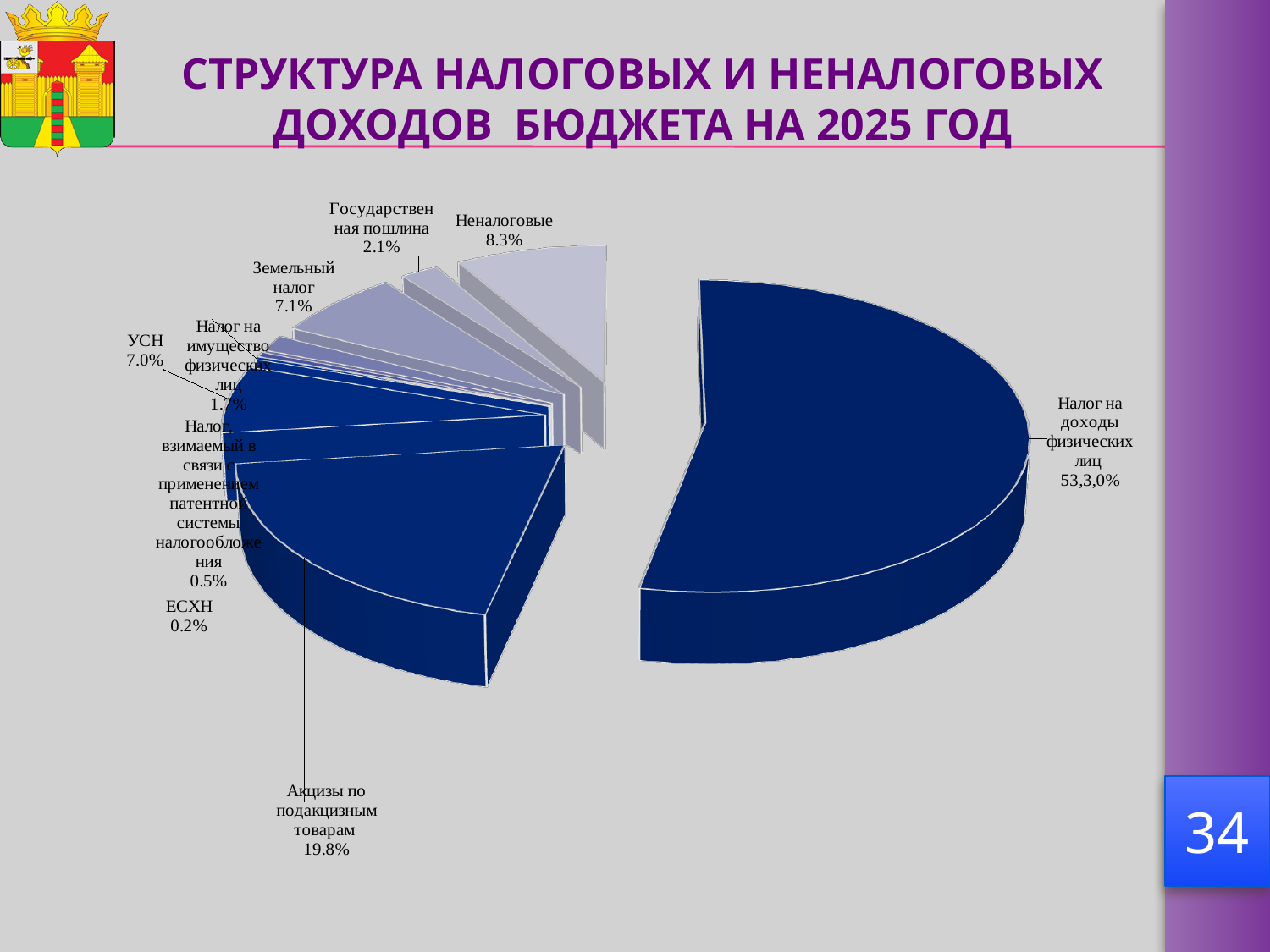
What percentage is shown for Земельный налог? 7.1% What is the value for УСН? 7.0% Which category has the largest slice of the pie? Налог на доходы физических лиц What percentage is shown for Государственная пошлина? 2.1% Which category has the smallest slice of the pie? ЕСХН What type of chart is shown on the slide? Pie chart What is the value shown for Неналоговые? 8.3% How many slices does the pie chart have? 9 Which is larger, Земельный налог or УСН? Земельный налог What is the difference in percentage points between Акцизы по подакцизным товарам and Неналоговые? 11.5 What share of the pie does Акцизы по подакцизным товарам account for? 19.8% What is the value for ЕСХН? 0.2%